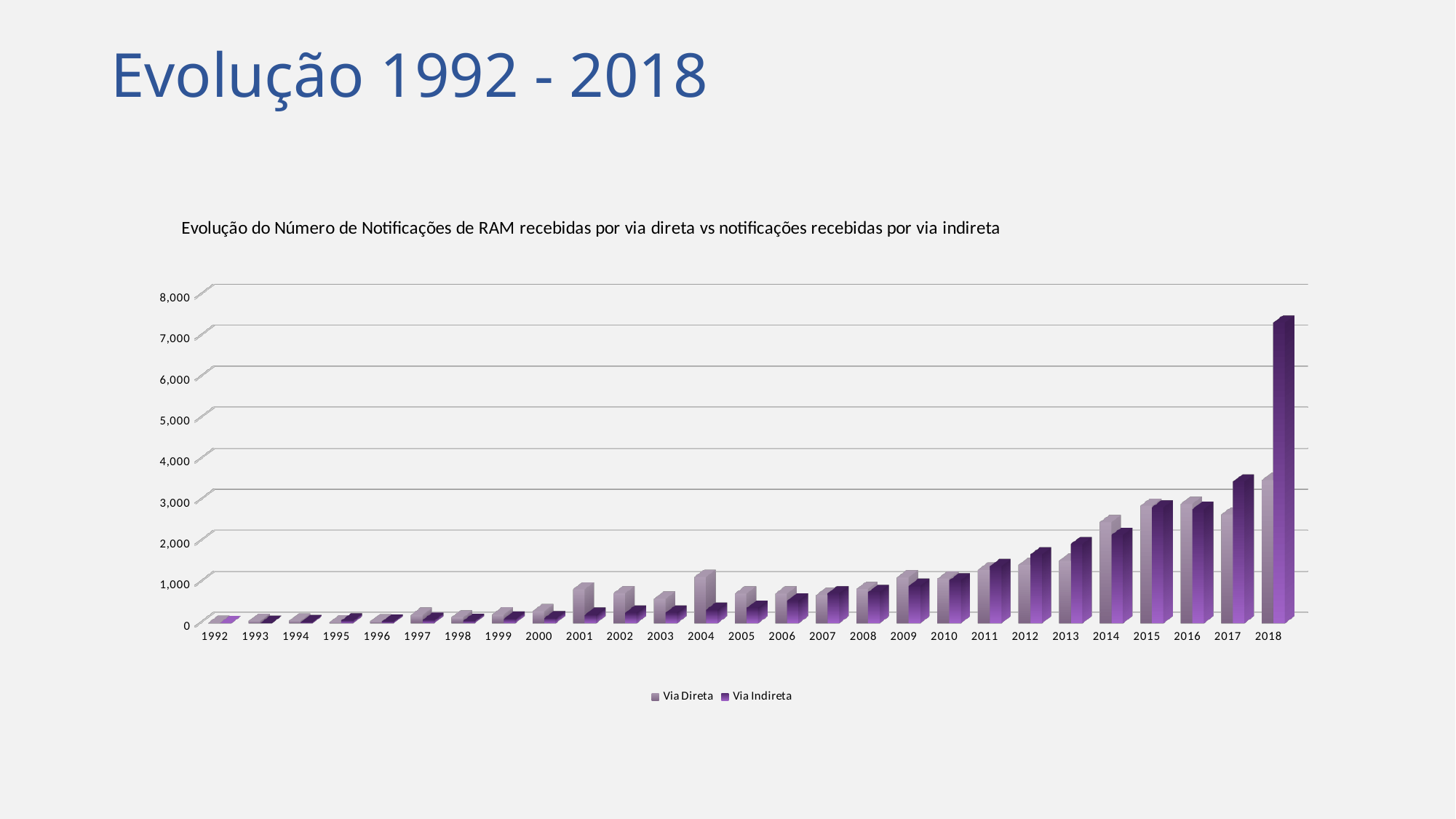
In which year is the Via Direta value highest? 2018 What are the two series named in the legend? Via Direta and Via Indireta Is the Via Indireta value for 2001 greater or less than 1,000? less What kind of chart is shown on the slide? Bar chart In 2004, which series has the larger value, Via Direta or Via Indireta? Via Direta In which year is the Via Indireta value highest? 2018 Do the Via Indireta values generally rise or fall from 1992 to 2018? Rise How many series does the legend list? 2 In 2018, which series has the larger value, Via Direta or Via Indireta? Via Indireta Is the Via Direta value for 2018 greater or less than 3,000? greater Is the Via Indireta value for 2018 greater or less than 6,000? greater How many years are shown on the x axis? 27